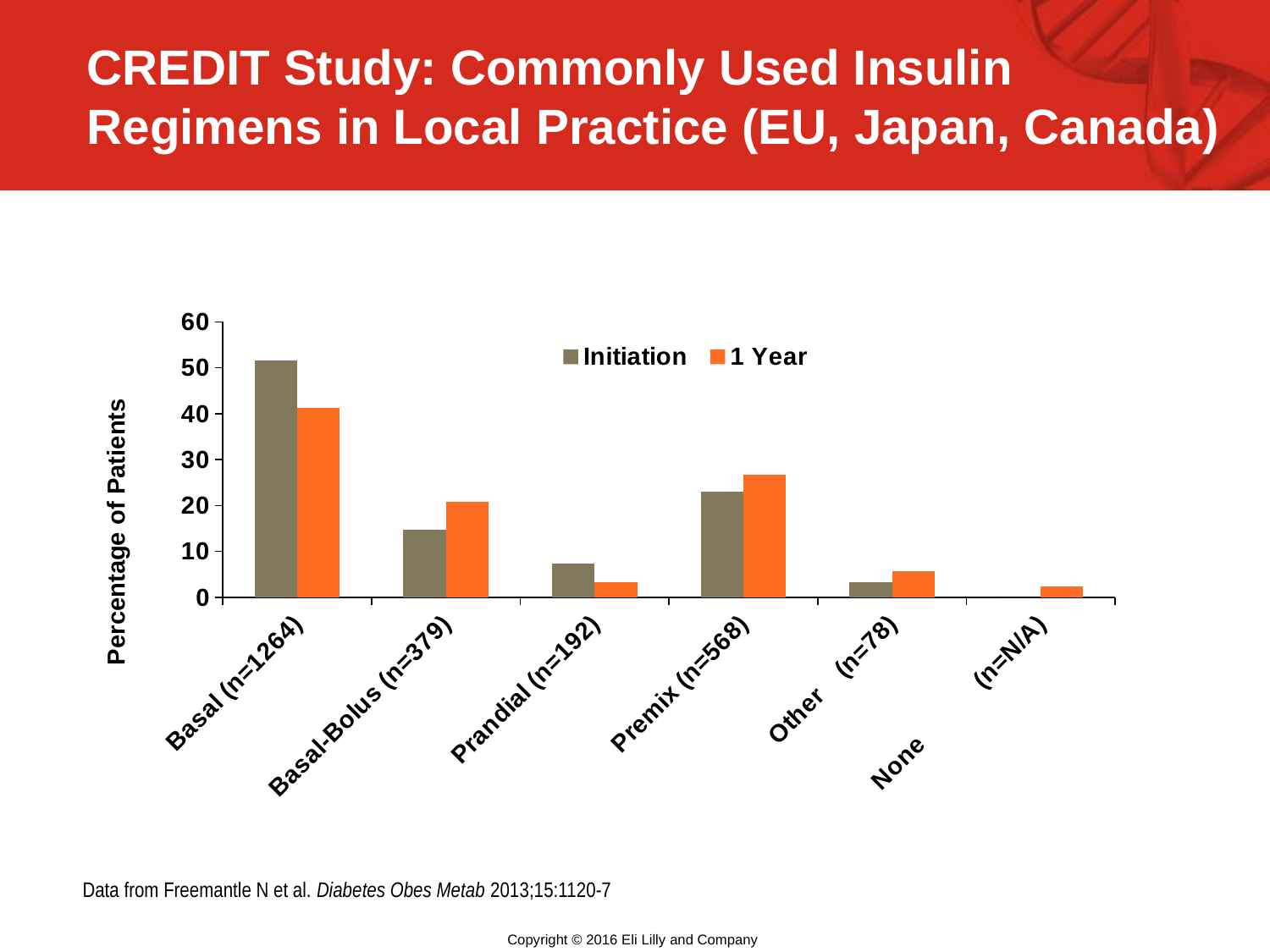
Is the 1 Year value for Basal (n=1264) greater or less than 30? greater For Premix (n=568), which is larger: the Initiation value or the 1 Year value? 1 Year Is the 1 Year value for Premix (n=568) greater or less than 30? less Which category has the highest Initiation value? Basal (n=1264) How many insulin regimen categories are shown on the x axis? 6 For Prandial (n=192), which is larger: the Initiation value or the 1 Year value? Initiation How many series does the legend list? 2 Is the Initiation value for Prandial (n=192) greater or less than 10? less What is the label of the y axis? Percentage of Patients Which category has the highest 1 Year value? Basal (n=1264) What kind of chart is shown on the slide? Bar chart